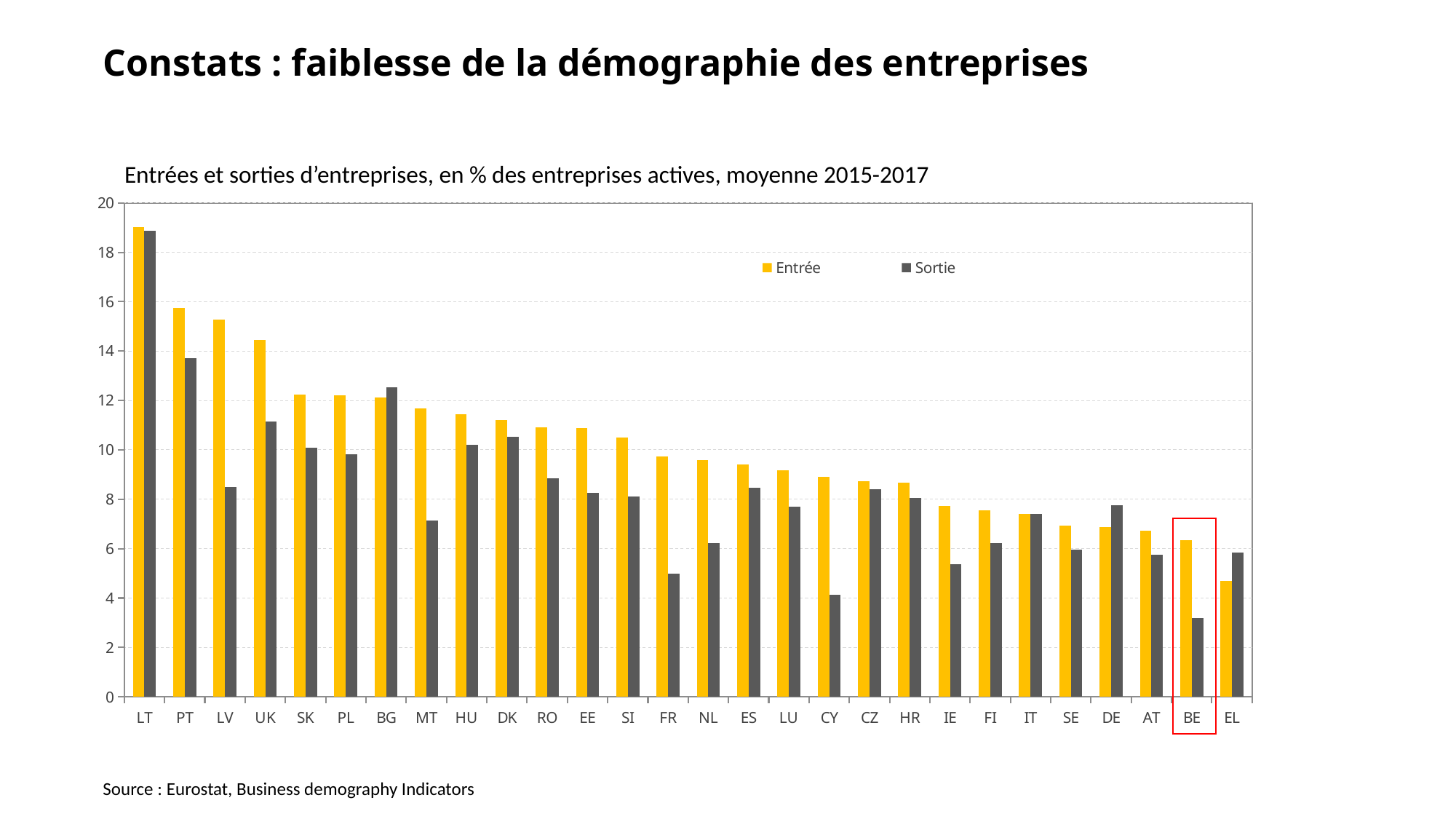
Do the Entrée values rise or fall from left to right along the x axis? fall What kind of chart is shown on the slide? bar chart Which country is highlighted with a red box on the chart? BE Is the Sortie value for CY greater or less than 6? less How many series does the legend list? 2 Is the Entrée value for LT greater or less than 18? greater Which country has the lowest Entrée value? EL Is the Sortie value for BE greater or less than 4? less How many countries are shown on the x axis? 28 For DE, which is larger, the Entrée value or the Sortie value? Sortie Which country has the lowest Sortie value? BE Which country has the highest Entrée value? LT